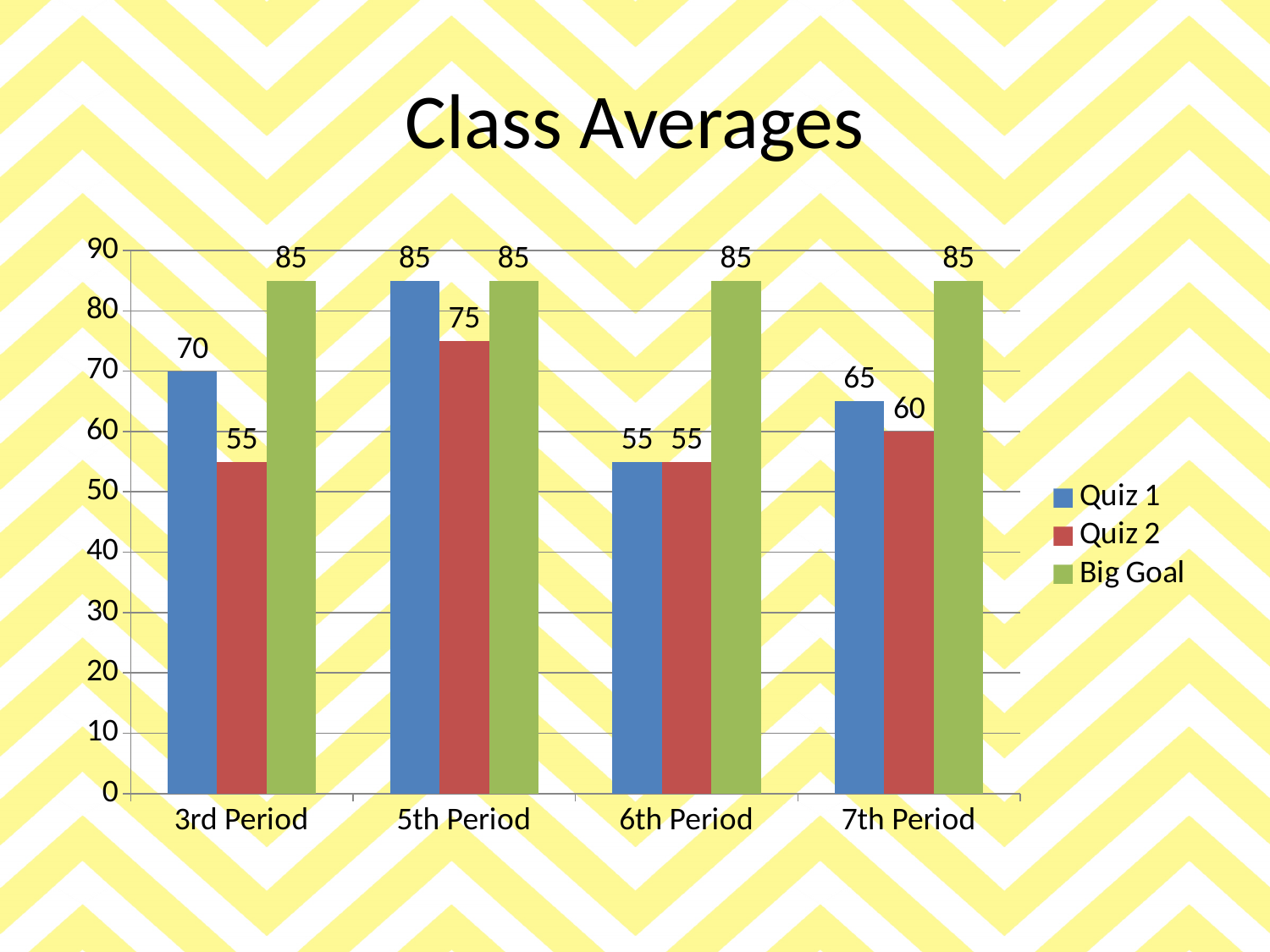
What is the title of the chart? Class Averages What is the difference between the Quiz 1 and Quiz 2 values for 3rd Period? 15 What is the Quiz 1 value for 3rd Period? 70 What is the Quiz 2 value for 5th Period? 75 How many series does the legend list? 3 Which period has the highest Quiz 1 value? 5th Period What kind of chart is shown on the slide? Bar chart What is the Quiz 2 value for 7th Period? 60 Which period has the lowest Quiz 1 value? 6th Period What is the Big Goal value for 6th Period? 85 Which is larger for 7th Period, Quiz 1 or Quiz 2? Quiz 1 How many periods are shown on the x axis? 4